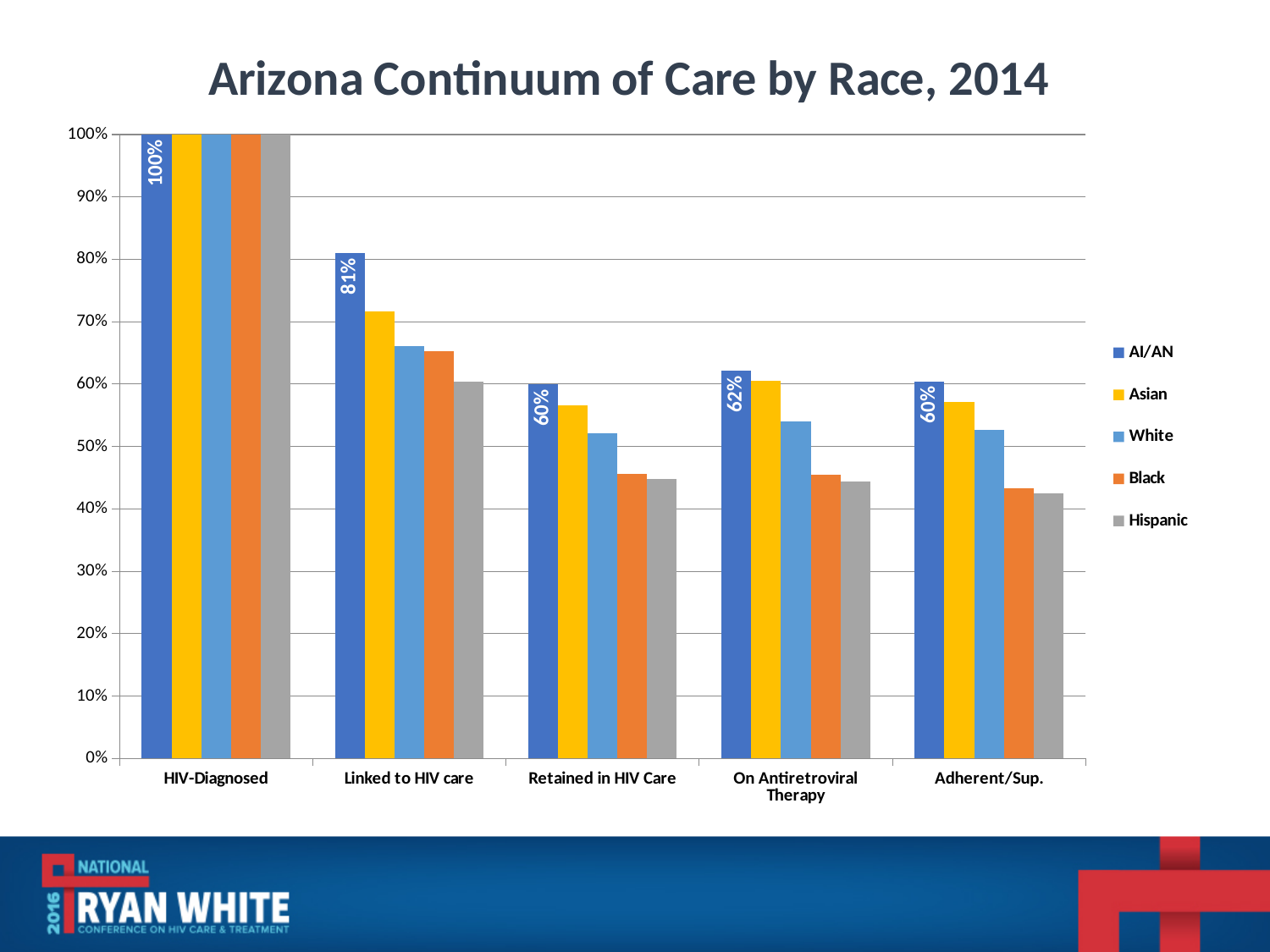
What is the difference between the AI/AN values for HIV-Diagnosed and Linked to HIV care? 19% How many series does the legend list? 5 How many categories are shown on the x axis? 5 What kind of chart is shown on the slide? Bar chart In the Adherent/Sup. category, which is larger, the Asian value or the White value? Asian Which race has the highest value in the Linked to HIV care category? AI/AN What is the value for AI/AN in the Linked to HIV care category? 81% What is the value for AI/AN in the Adherent/Sup. category? 60% Is the value for White in the Linked to HIV care category greater or less than 60%? greater What is the value for AI/AN in the On Antiretroviral Therapy category? 62% Is the value for Hispanic in the Retained in HIV Care category greater or less than 50%? less Which race has the lowest value in the Linked to HIV care category? Hispanic